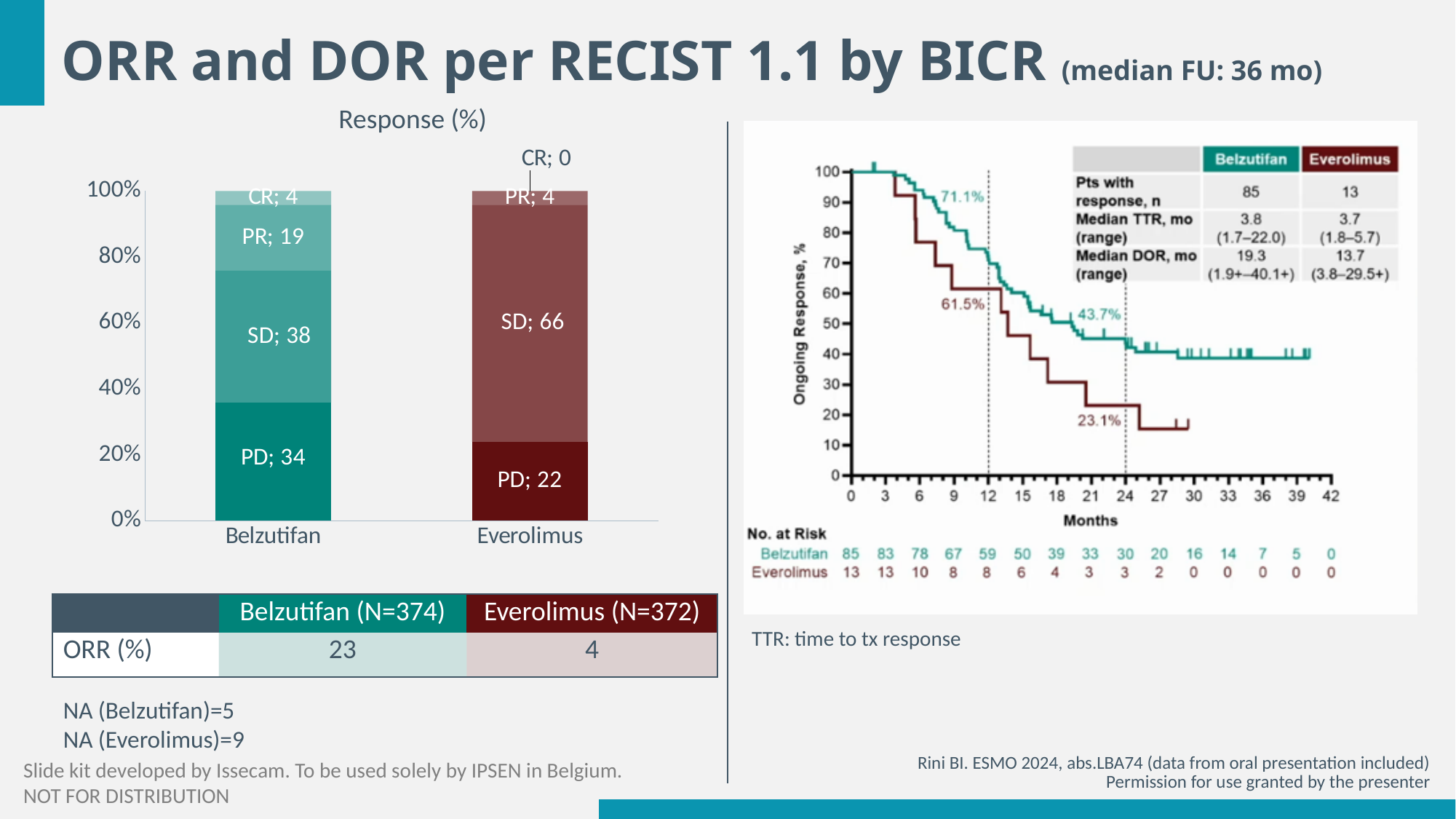
How many bars are shown in the Response (%) chart on the left? 2 In the Response (%) bar chart on the left, what is the CR value for Everolimus? 0 In the Response (%) bar chart on the left, what is the PR value for Belzutifan? 19 In the Response (%) bar chart on the left, what is the total of the four labelled segments in the Belzutifan bar? 95 In the Response (%) bar chart on the left, which treatment has the larger PD value, Belzutifan or Everolimus? Belzutifan In the Response (%) bar chart on the left, what is the PD value for Everolimus? 22 In the Ongoing Response chart on the right, what is the labelled Everolimus ongoing response at 24 months? 23.1% In the Response (%) bar chart on the left, what is the SD value for Belzutifan? 38 In the Ongoing Response chart on the right, what is the labelled Belzutifan ongoing response at 12 months? 71.1% In the Response (%) bar chart on the left, how much larger is the SD value for Everolimus than for Belzutifan? 28 What kind of chart is the Ongoing Response chart on the right? Line chart What kind of chart is the Response (%) chart on the left? Stacked bar chart